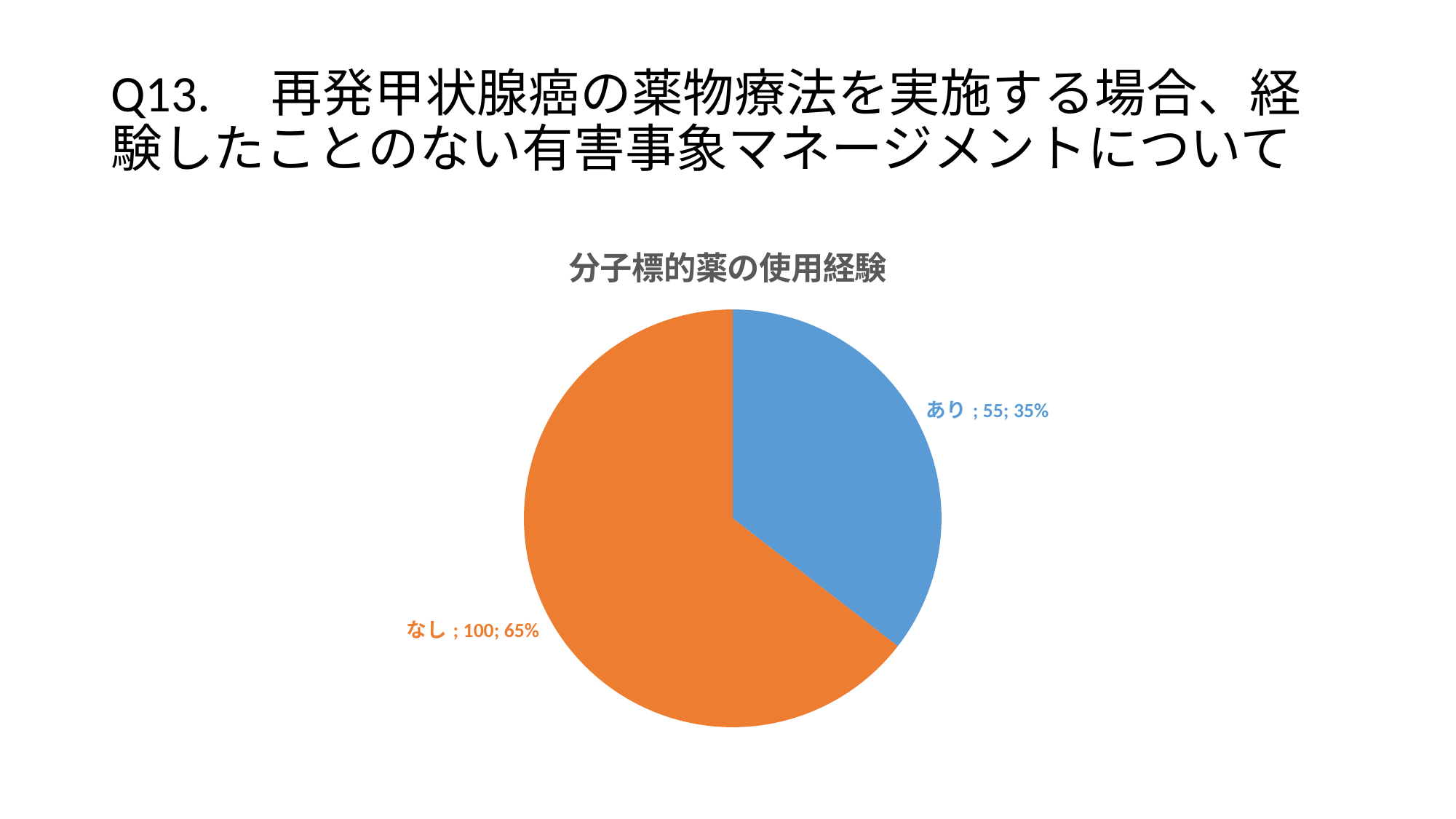
What share of the pie does なし represent? 65% What is the count for なし? 100 Which category has the smallest slice? あり Which is larger, the count for あり or the count for なし? なし What is the difference between the counts for なし and あり? 45 What is the title of the chart? 分子標的薬の使用経験 What colour is the slice for あり? blue What share of the pie does あり represent? 35% What is the count for あり? 55 Which category has the largest slice? なし How many slices does the pie chart have? 2 What kind of chart is shown on the slide? pie chart